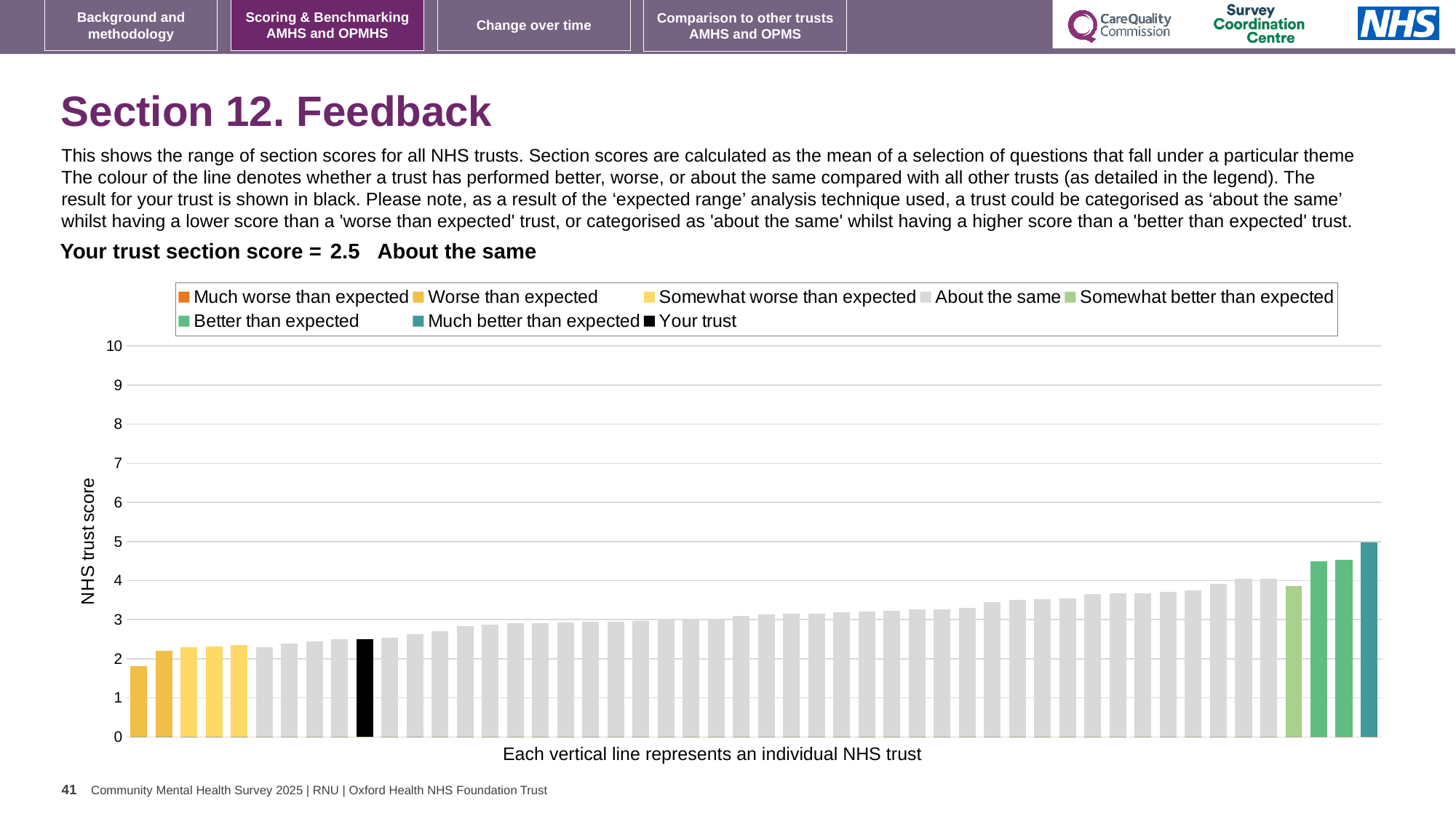
Do the bar values rise or fall from left to right along the x axis? Rise What kind of chart is shown on the slide? Bar chart Is the value of the black 'Your trust' bar greater or less than 2? greater Is the value of the tallest bar (rightmost) greater or less than 4? greater What is the section score for your trust shown on the slide? 2.5 Is the value of the shortest bar (leftmost) greater or less than 2? less How many entries does the chart legend list? 8 What is the label on the vertical axis of the chart? NHS trust score How many bars are coloured as 'Much better than expected' (teal)? 1 Which category is your trust placed in according to the slide? About the same What colour is the bar representing your trust? Black